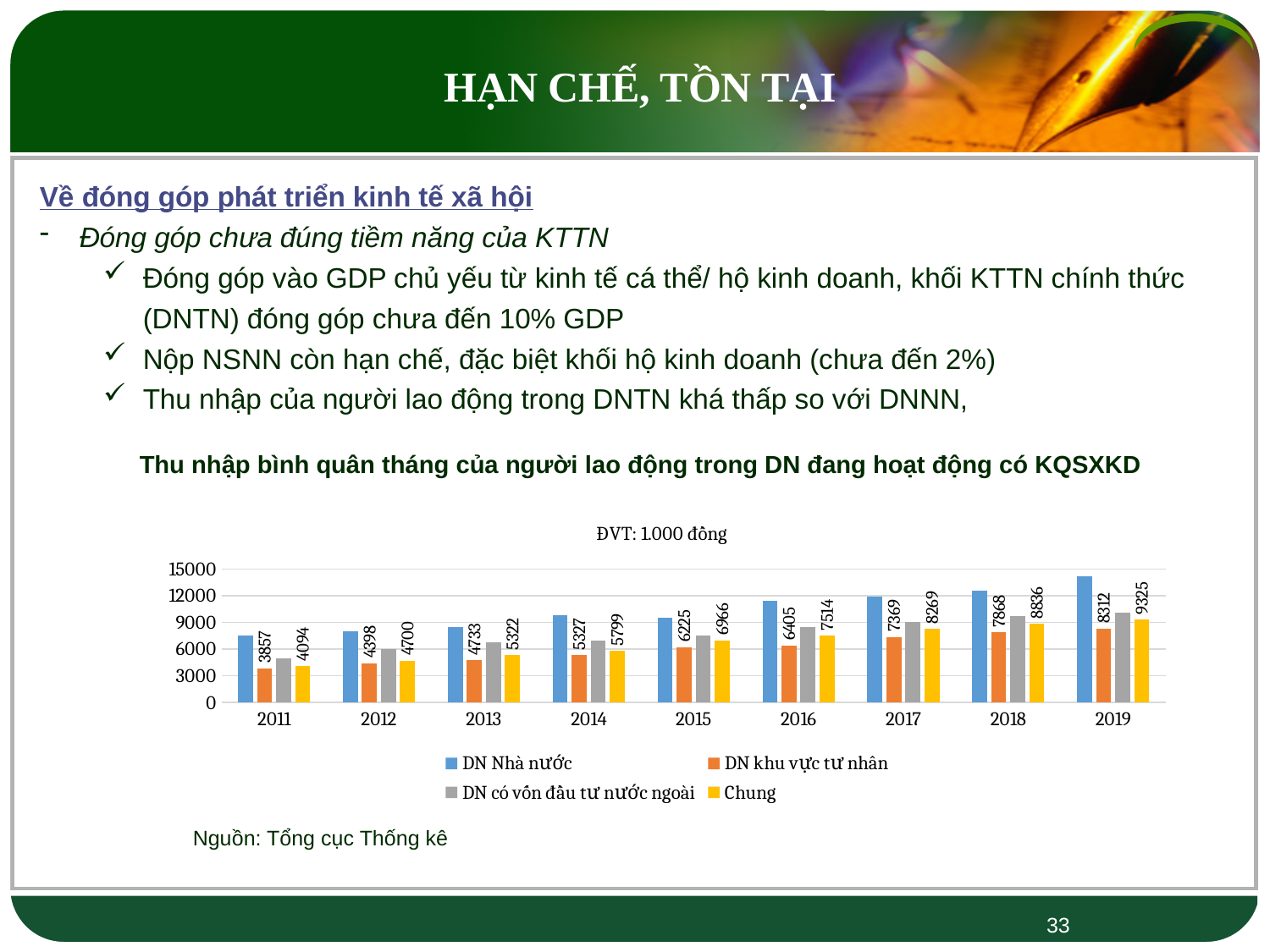
What is the difference between the Chung value and the DN khu vực tư nhân value in 2018? 968 Is the value for DN có vốn đầu tư nước ngoài in 2011 greater or less than 6000? less How many years are shown on the x axis of the chart? 9 In which year is the value for DN khu vực tư nhân the lowest? 2011 What kind of chart is shown on the slide? Bar chart Is the value for DN Nhà nước in 2019 greater or less than 12000? greater In which year is the value for Chung the highest? 2019 What is the value for DN khu vực tư nhân in 2011? 3857 How many series does the chart legend list? 4 What is the value for DN khu vực tư nhân in 2015? 6225 Which is larger in 2016: the value for DN khu vực tư nhân or the value for Chung? Chung What is the value for Chung in 2019? 9325